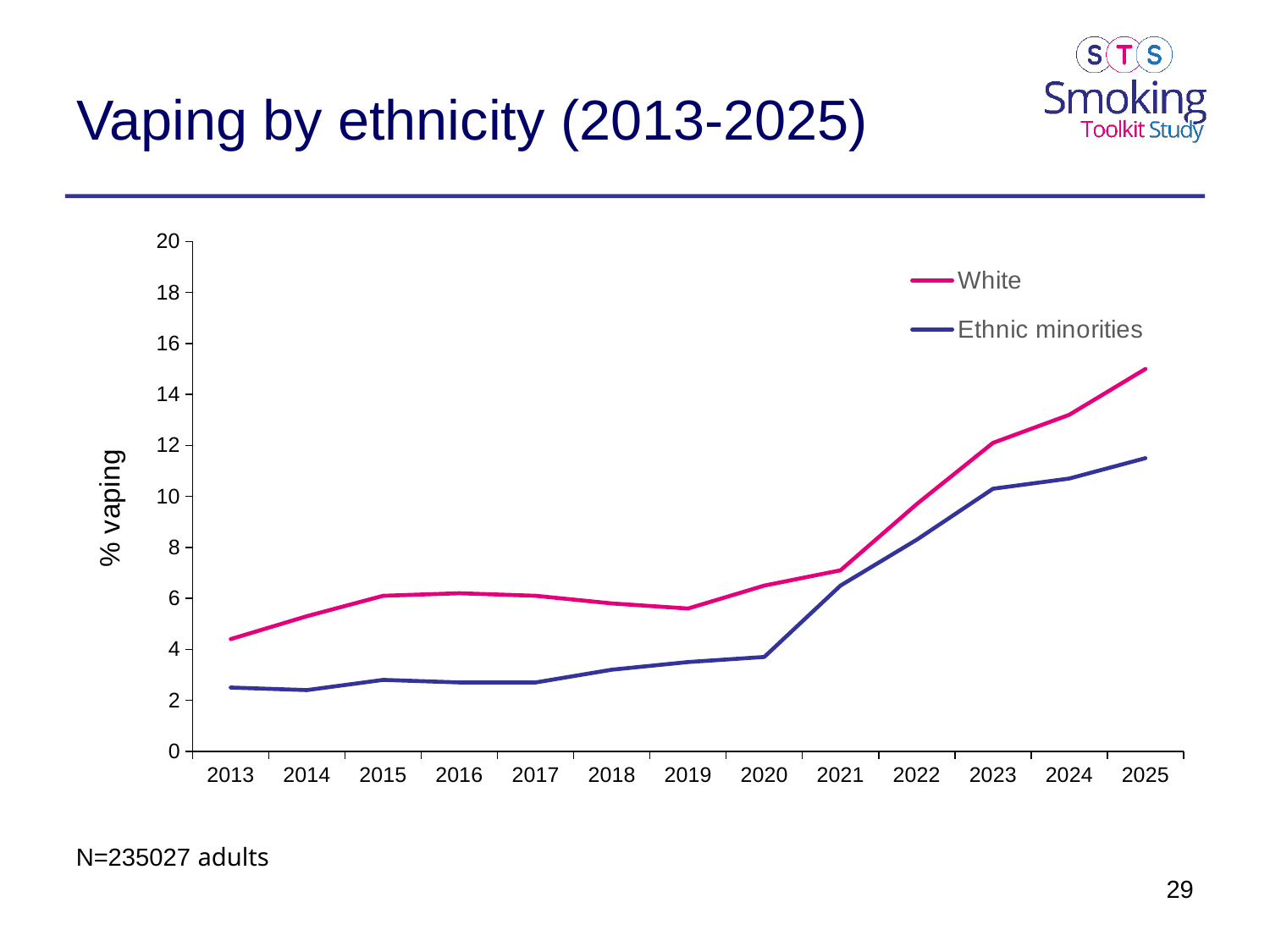
What kind of chart is shown on the slide? Line chart Is the value for White in 2025 greater or less than 14? greater Is the value for Ethnic minorities in 2013 greater or less than 4? less In which year is the White series at its lowest? 2013 Is the value for White in 2013 greater or less than 6? less How many series does the legend list? 2 In 2025, which series has the higher value, White or Ethnic minorities? White How many years are labelled on the x axis? 13 Does the Ethnic minorities series rise or fall between 2020 and 2025? Rise In which year is the White series at its highest? 2025 What is the label on the y axis? % vaping